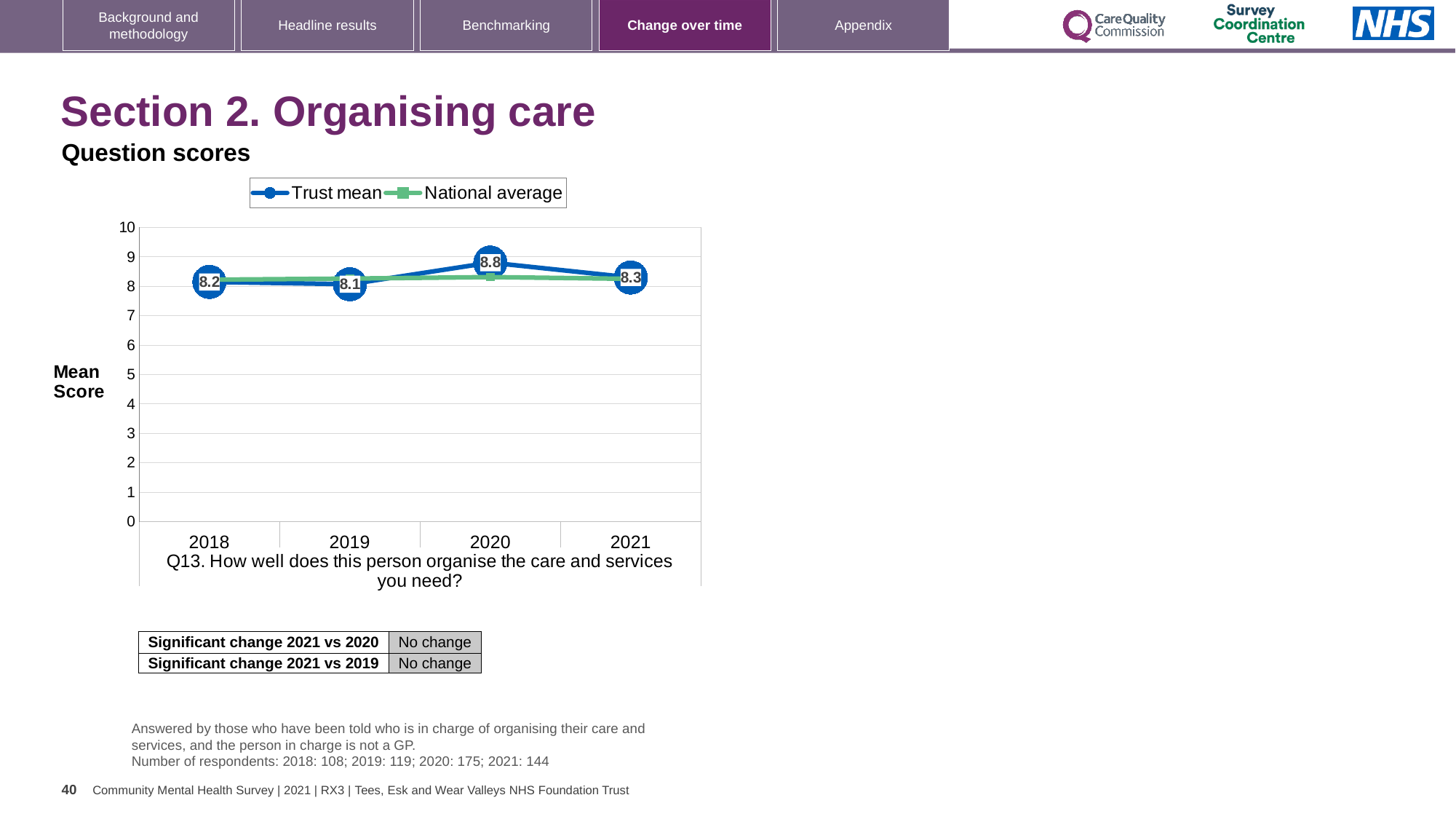
In which year is the Trust mean score highest? 2020 Is the National average for 2020 greater or less than 7? greater Which is larger, the Trust mean score for 2018 or for 2021? 2021 In which year is the Trust mean score lowest? 2019 What is the Trust mean score for 2018? 8.2 How many years are plotted on the x axis? 4 What is the Trust mean score for 2021? 8.3 What is the Trust mean score for 2020? 8.8 What is the difference between the Trust mean scores for 2020 and 2019? 0.7 Which question is the chart about, according to the x-axis label? Q13. How well does this person organise the care and services you need? What kind of chart is shown on the slide? Line chart How many series does the legend list? 2